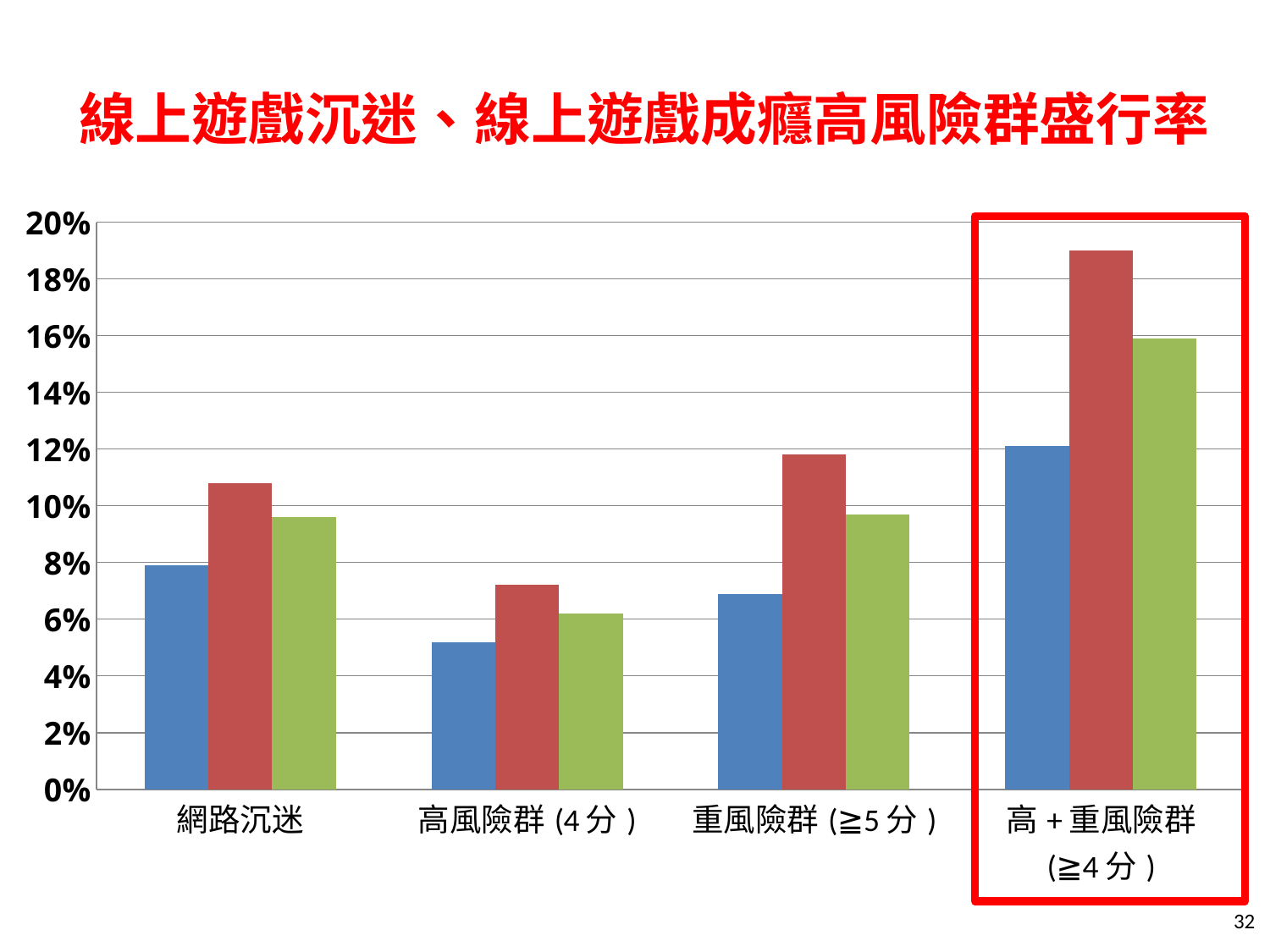
Is the blue bar for 高＋重風險群 (≧4分) greater or less than 10%? greater Is the blue bar for 高風險群 (4分) greater or less than 6%? less Is the red bar for 高＋重風險群 (≧4分) greater or less than 18%? greater Which category has the tallest bar in the chart? 高＋重風險群 (≧4分) Within the 網路沉迷 category, which bar is taller, the blue bar or the green bar? the green bar Which bar is taller, the red bar for 重風險群 (≧5分) or the red bar for 高風險群 (4分)? the red bar for 重風險群 (≧5分) Which category has the shortest bar in the chart? 高風險群 (4分) What kind of chart is shown on the slide? bar chart How many categories are shown on the x axis of the chart? 4 Which category on the chart is highlighted with a red box? 高＋重風險群 (≧4分)